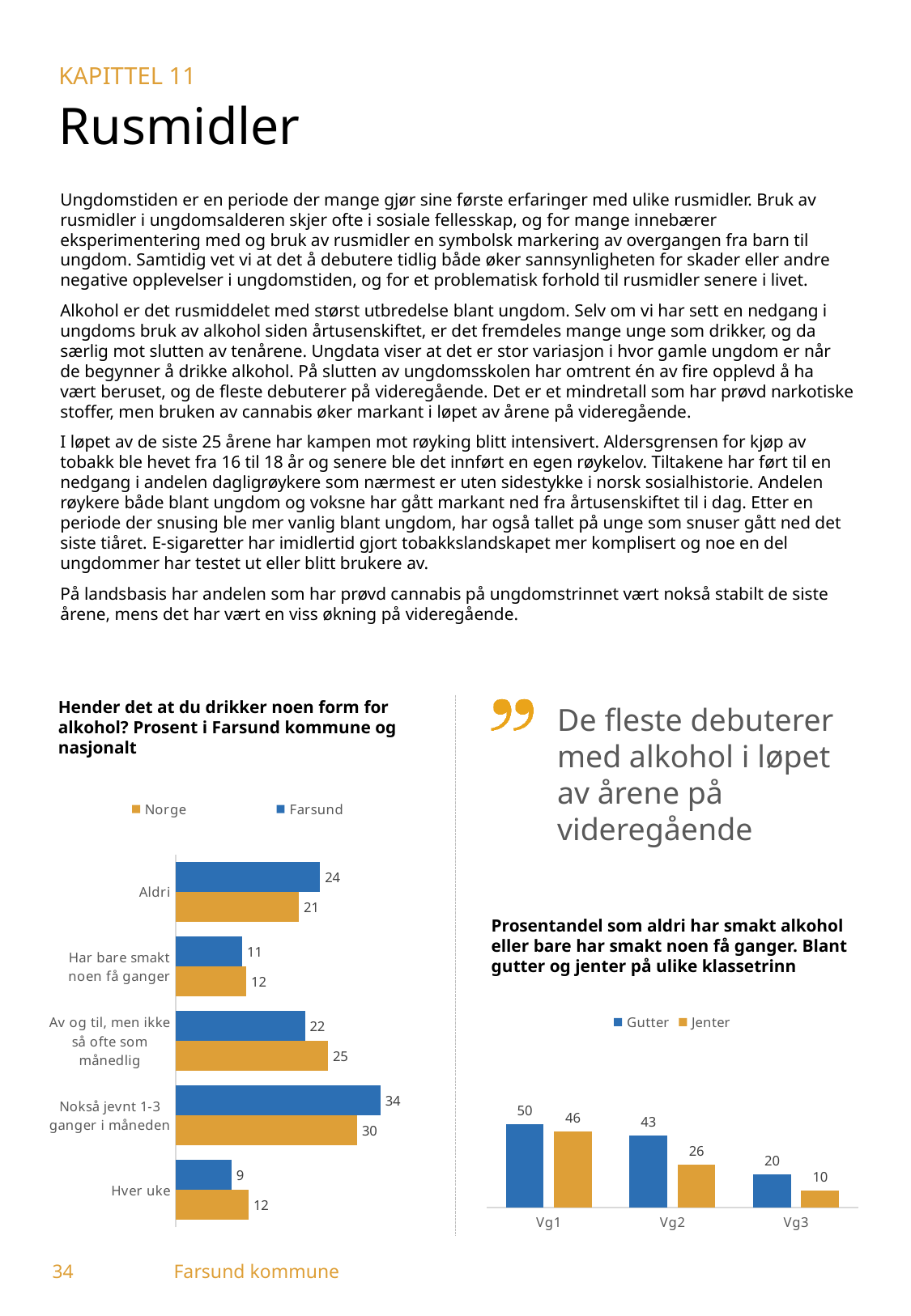
In the chart 'Hender det at du drikker noen form for alkohol?', what is the Farsund value for 'Nokså jevnt 1-3 ganger i måneden'? 34 In the chart 'Hender det at du drikker noen form for alkohol?', what is the difference between the Norge and Farsund values for 'Hver uke'? 3 What type of chart is 'Hender det at du drikker noen form for alkohol?'? Bar chart In the chart 'Prosentandel som aldri har smakt alkohol eller bare har smakt noen få ganger', which class level has the highest value for Gutter? Vg1 In the chart 'Prosentandel som aldri har smakt alkohol eller bare har smakt noen få ganger', what is the value for Jenter at Vg2? 26 In the chart 'Hender det at du drikker noen form for alkohol?', which category has the lowest Farsund value? Hver uke In the chart 'Hender det at du drikker noen form for alkohol?', what is the Norge value for 'Aldri'? 21 How many categories are shown in the chart 'Hender det at du drikker noen form for alkohol?'? 5 In the chart 'Hender det at du drikker noen form for alkohol?', which is larger for 'Av og til, men ikke så ofte som månedlig': Norge or Farsund? Norge How many series does the legend list in the chart 'Prosentandel som aldri har smakt alkohol eller bare har smakt noen få ganger'? 2 In the chart 'Prosentandel som aldri har smakt alkohol eller bare har smakt noen få ganger', do the Jenter values rise or fall from Vg1 to Vg3? Fall In the chart 'Prosentandel som aldri har smakt alkohol eller bare har smakt noen få ganger', what is the difference between Gutter and Jenter at Vg3? 10